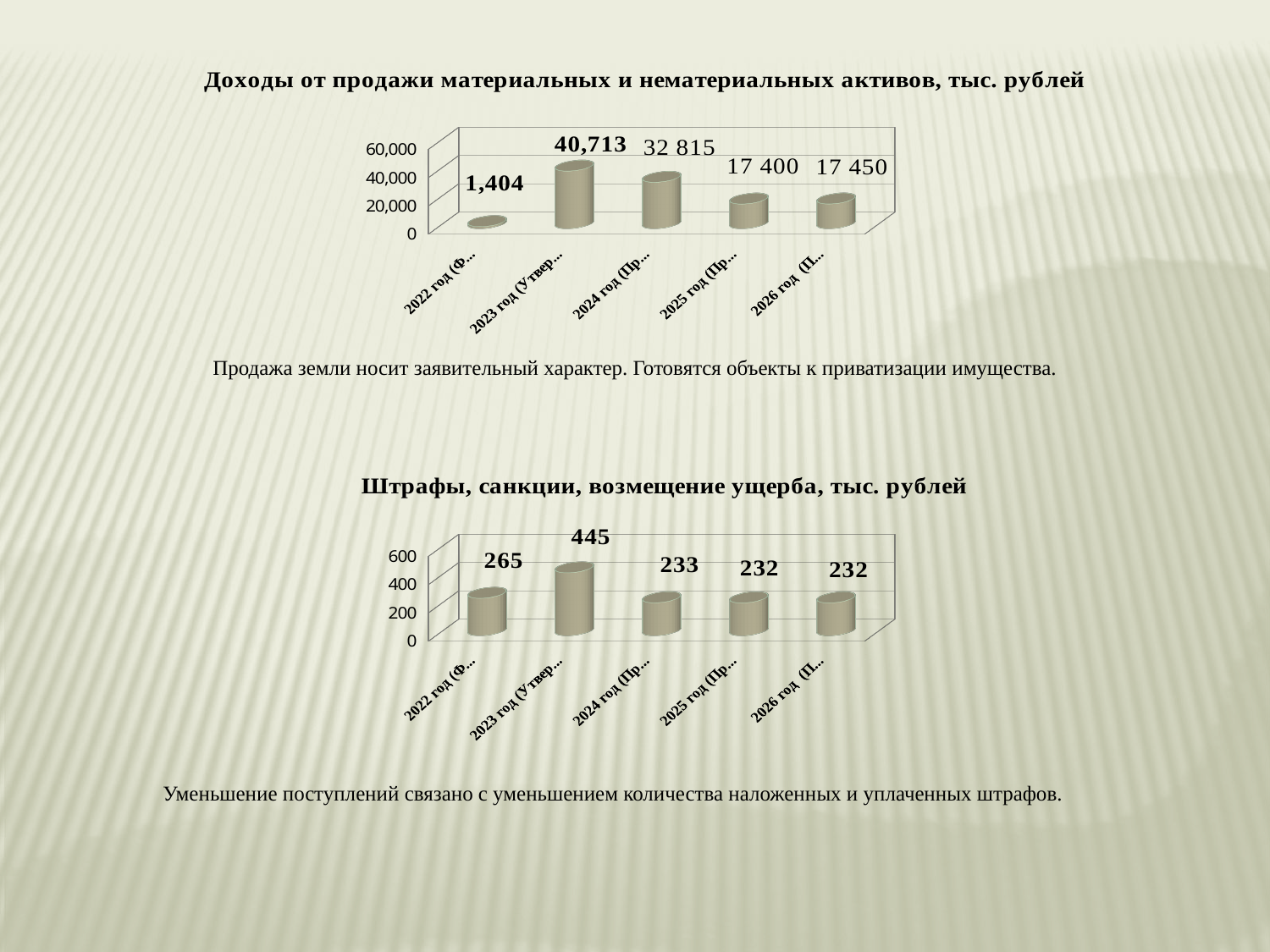
In the chart titled "Доходы от продажи материальных и нематериальных активов, тыс. рублей", which year has the highest value? 2023 год What kind of chart is the bottom chart on the slide? bar chart In the chart titled "Доходы от продажи материальных и нематериальных активов, тыс. рублей", what is the difference between the values for 2026 год and 2025 год? 50 In the chart titled "Доходы от продажи материальных и нематериальных активов, тыс. рублей", what is the value for 2023 год? 40,713 In the chart titled "Штрафы, санкции, возмещение ущерба, тыс. рублей", what is the difference between the values for 2023 год and 2022 год? 180 In the chart titled "Штрафы, санкции, возмещение ущерба, тыс. рублей", what is the value for 2023 год? 445 In the chart titled "Штрафы, санкции, возмещение ущерба, тыс. рублей", which year has the highest value? 2023 год In the chart titled "Доходы от продажи материальных и нематериальных активов, тыс. рублей", what is the value for 2022 год? 1,404 In the chart titled "Доходы от продажи материальных и нематериальных активов, тыс. рублей", which year has the lowest value? 2022 год In the chart titled "Штрафы, санкции, возмещение ущерба, тыс. рублей", is the value for 2022 год larger or smaller than the value for 2024 год? larger In the chart titled "Штрафы, санкции, возмещение ущерба, тыс. рублей", what is the value for 2025 год? 232 In the chart titled "Доходы от продажи материальных и нематериальных активов, тыс. рублей", how many bars are plotted? 5